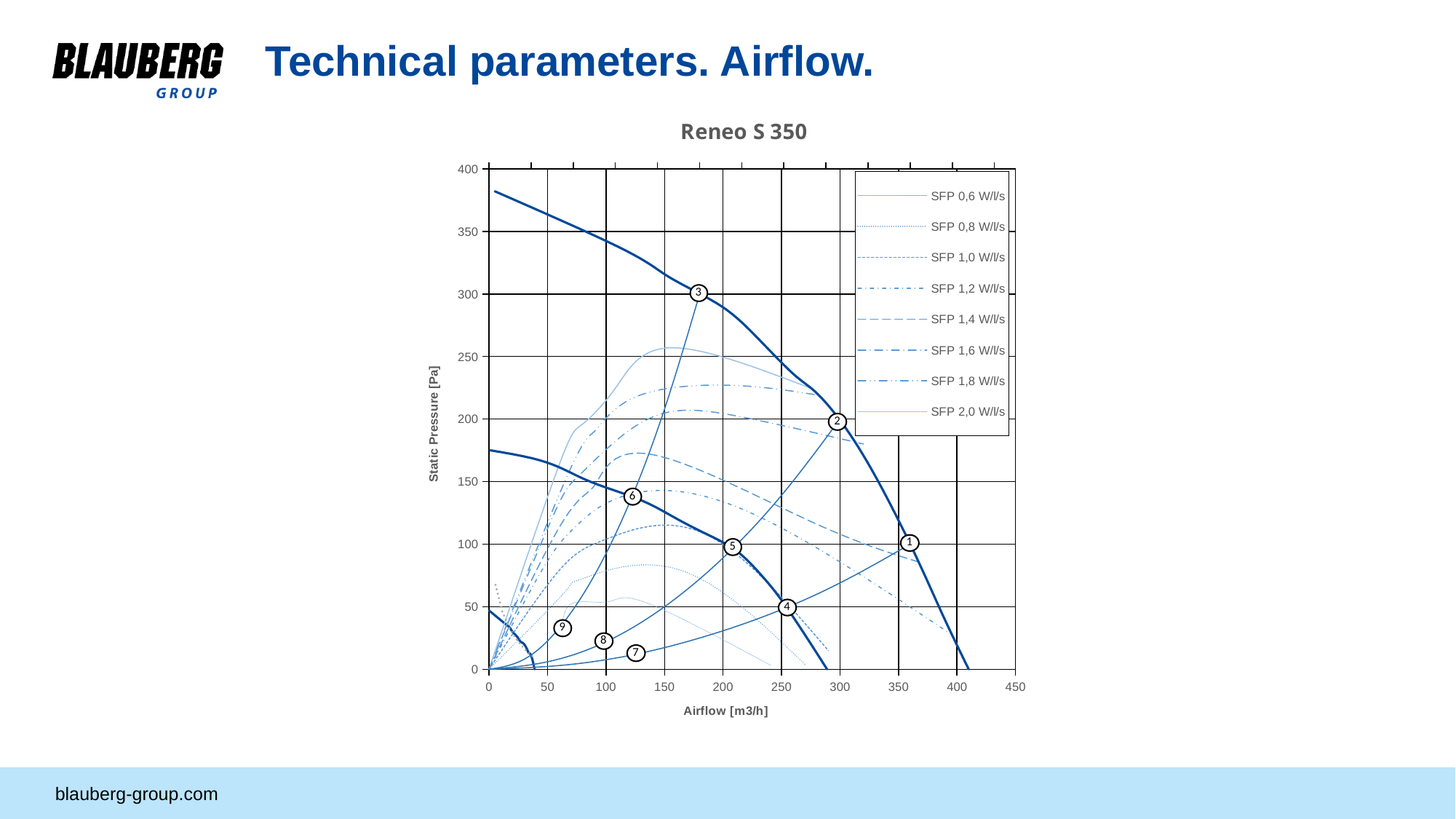
How many numbered operating points are marked on the chart? 9 What is the title of the chart? Reneo S 350 Does the static pressure along the uppermost bold fan curve rise or fall as airflow increases? fall How many SFP series does the legend list? 8 Is the static pressure at point 3 greater or less than 250 Pa? greater Which has the higher static pressure, point 3 or point 6? point 3 Is the airflow at point 1 greater or less than 300 m3/h? greater What kind of chart is shown on the slide? line chart What is the label of the horizontal axis? Airflow [m3/h] Is the static pressure at point 2 greater or less than 150 Pa? greater